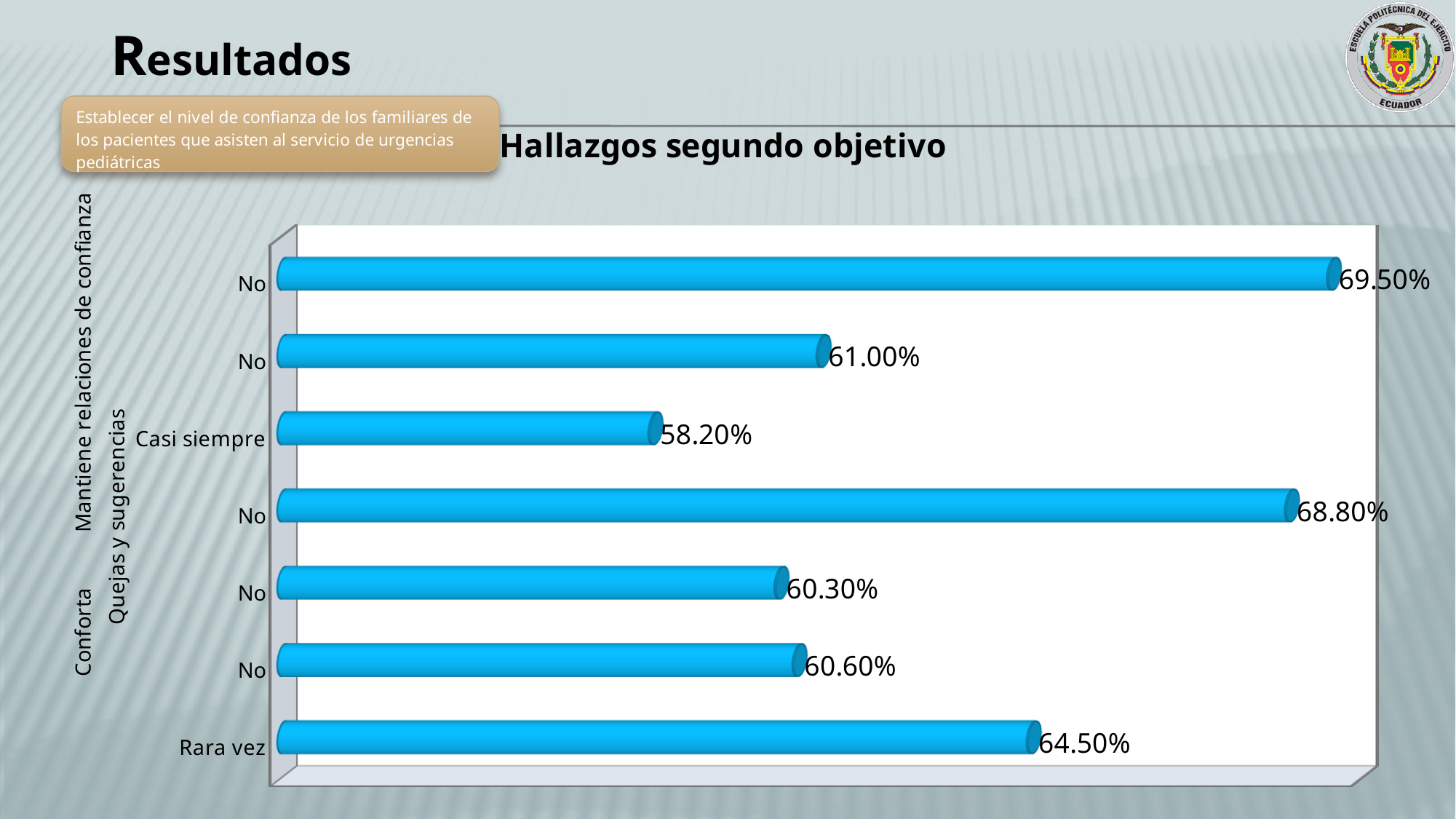
What is the value of the bar labelled "Casi siempre"? 58.20% How many bars does the chart contain? 7 What is the difference between the value for "Rara vez" and the value for "Casi siempre"? 6.30% Which is larger: the value for "Rara vez" or the value for "Casi siempre"? Rara vez What is the value of the bottom-most "No" bar (the one directly above "Rara vez")? 60.60% What is the value of the bar labelled "Rara vez"? 64.50% What is the title printed above the chart? Hallazgos segundo objetivo What is the value of the topmost bar in the chart? 69.50% What is the highest value shown in the chart? 69.50% What is the difference between the topmost bar (69.50%) and the second bar from the top (61.00%)? 8.50% Which bar has the lowest value in the chart? Casi siempre What kind of chart is shown on the slide? bar chart